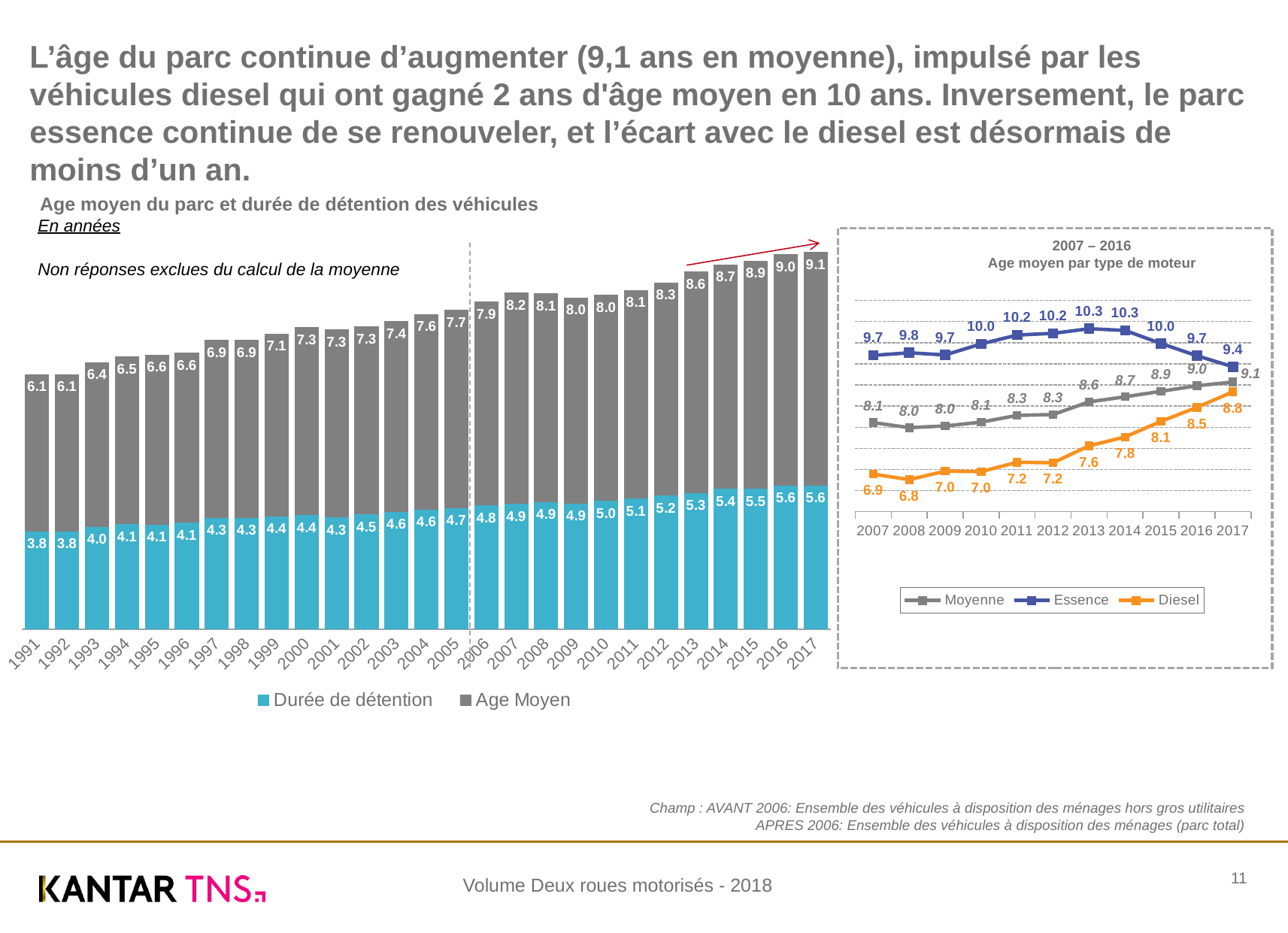
In the left bar chart, what is the Durée de détention value for 1991? 3.8 In the right chart 'Age moyen par type de moteur', does the Diesel series rise or fall from 2007 to 2017? rise In the left bar chart, how many series does the legend list? 2 In the right chart 'Age moyen par type de moteur', which year has the lowest Diesel value? 2008 In the right chart 'Age moyen par type de moteur', what is the difference between the Essence and Diesel values in 2017? 0.6 What kind of chart is the left chart 'Age moyen du parc et durée de détention des véhicules'? bar chart In the left bar chart, what is the Age Moyen value for 2017? 9.1 In the right chart 'Age moyen par type de moteur', how many series does the legend list? 3 In the left bar chart, what is the Durée de détention value for 2017? 5.6 In the left bar chart, what is the Age Moyen value for 2007? 8.2 In the right chart 'Age moyen par type de moteur', which series has the highest value in 2007? Essence In the right chart 'Age moyen par type de moteur', what is the Essence value for 2013? 10.3